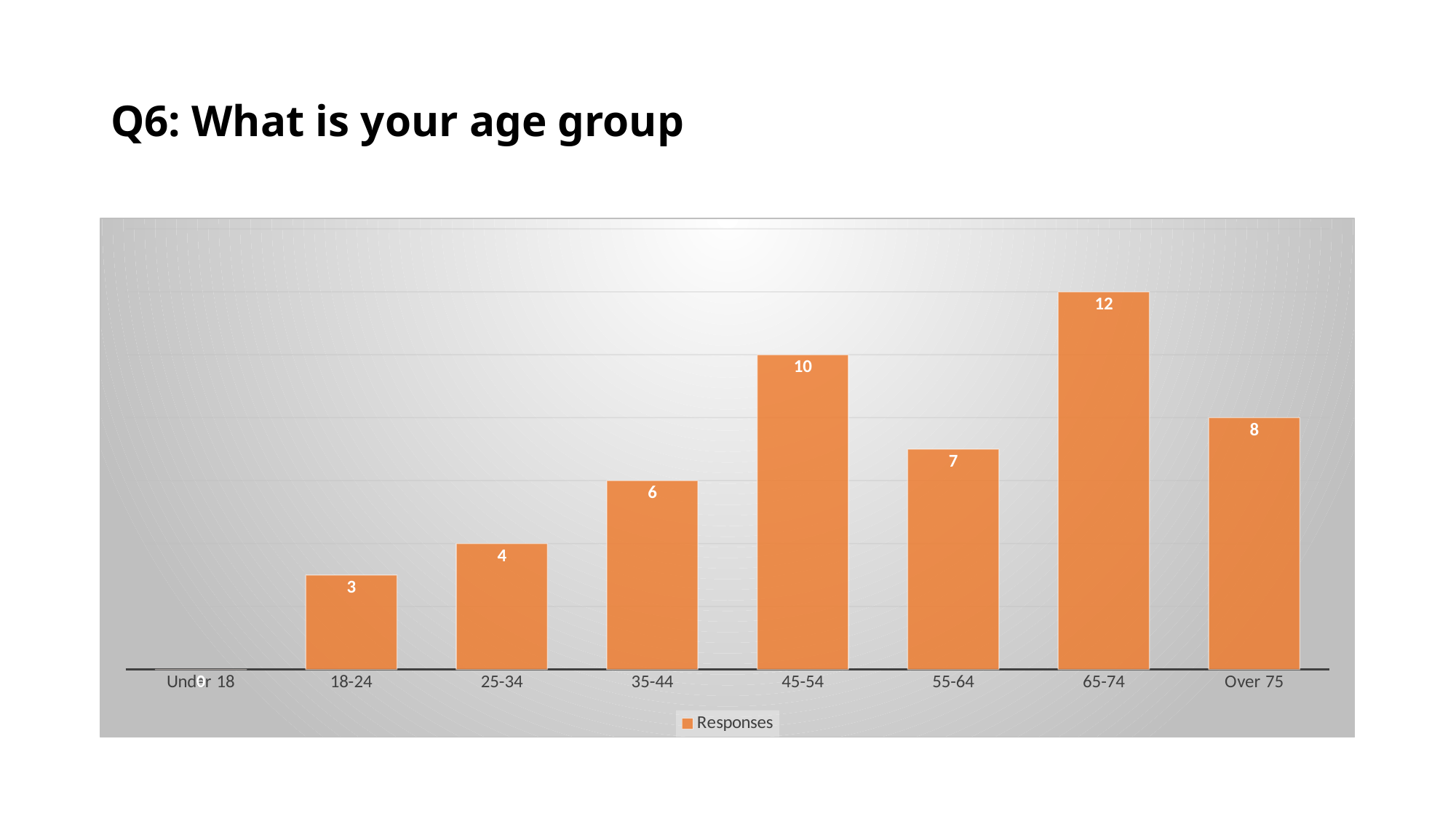
How many series does the legend list? 1 What is the difference in responses between the 65-74 and 55-64 age groups? 5 How many responses are in the 18-24 age group? 3 How many responses are in the Over 75 age group? 8 What is the name of the series shown in the legend? Responses Which age group has the highest number of responses? 65-74 How many responses are in the 45-54 age group? 10 What is the difference in responses between the 35-44 and 25-34 age groups? 2 What kind of chart is shown on the slide? Bar chart Which age group has more responses, 45-54 or Over 75? 45-54 How many age group categories are shown on the x axis? 8 Which age group has the lowest number of responses? Under 18